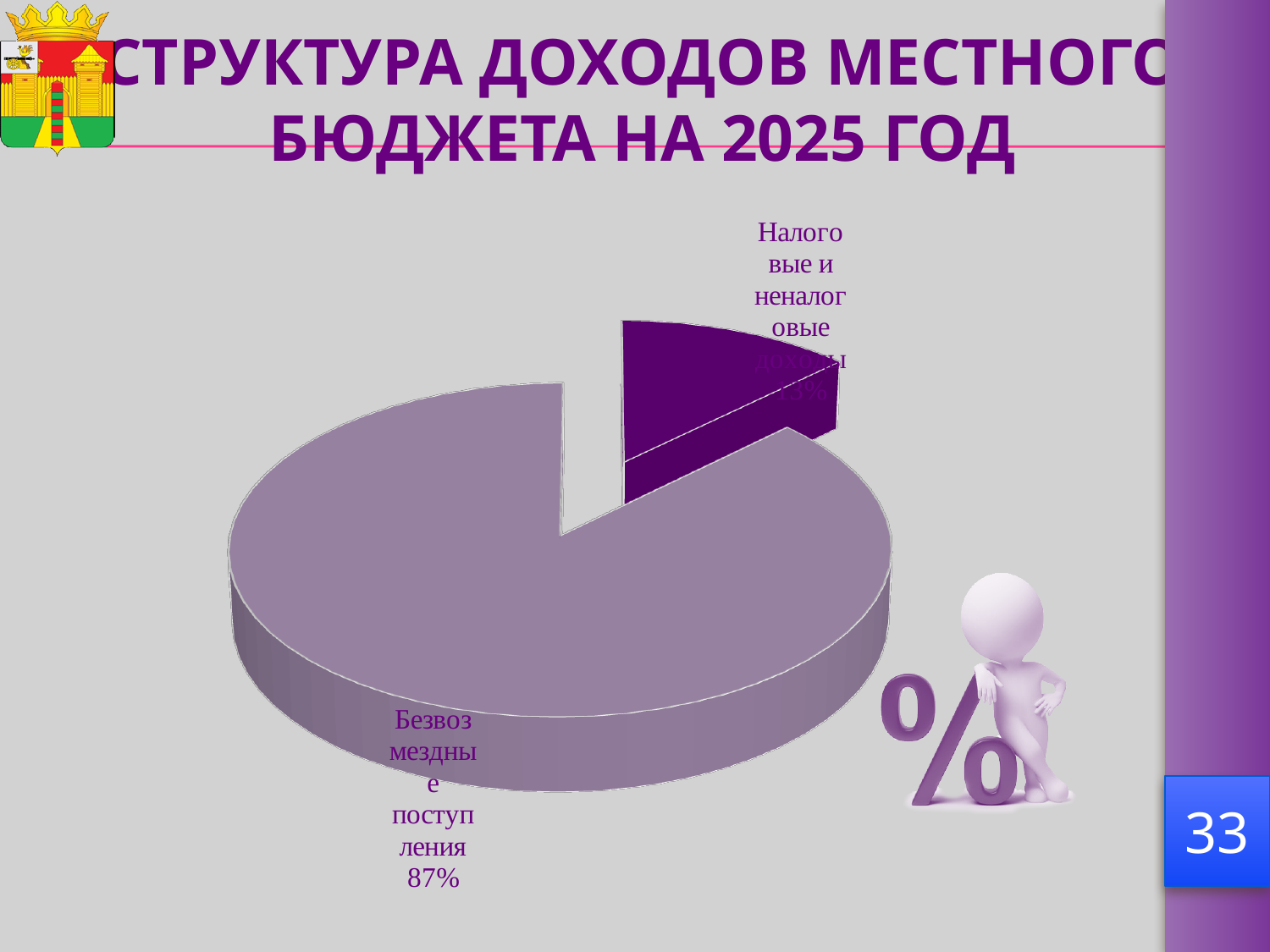
What is the title of the slide containing the chart? СТРУКТУРА ДОХОДОВ МЕСТНОГО БЮДЖЕТА НА 2025 ГОД Which slice of the pie is the largest? Безвозмездные поступления What is the difference in percentage points between Безвозмездные поступления and Налоговые и неналоговые доходы? 74 Which is larger: Безвозмездные поступления or Налоговые и неналоговые доходы? Безвозмездные поступления What share of the pie is labelled for Налоговые и неналоговые доходы? 13% How many slices does the pie chart have? 2 What share of the pie is labelled for Безвозмездные поступления? 87% Which slice of the pie is the smallest? Налоговые и неналоговые доходы Which slice is pulled out (exploded) from the pie? Налоговые и неналоговые доходы What kind of chart is shown on the slide? Pie chart